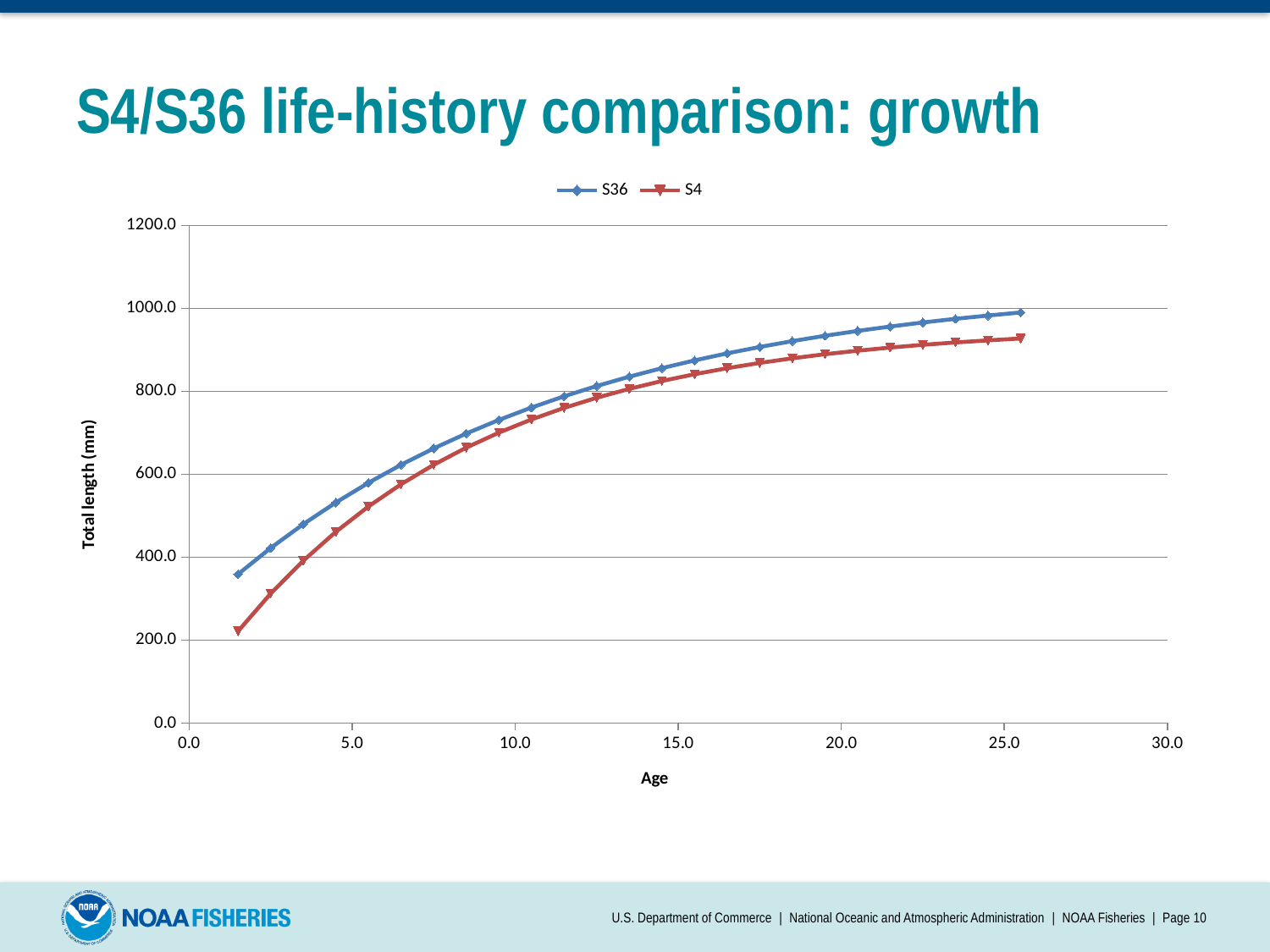
What is the label of the y axis? Total length (mm) Is the value for S4 at the oldest age plotted greater or less than 800? greater Which series has the higher total length at the youngest age plotted, S36 or S4? S36 How many series does the legend list? 2 What is the label of the x axis? Age Which series reaches the higher total length at the oldest age plotted, S36 or S4? S36 Is the value for S36 at the youngest age plotted greater or less than 200? greater Do the values for S36 rise or fall as age increases? rise What kind of chart is shown on the slide? line chart Is the value for S4 at the youngest age plotted greater or less than 400? less